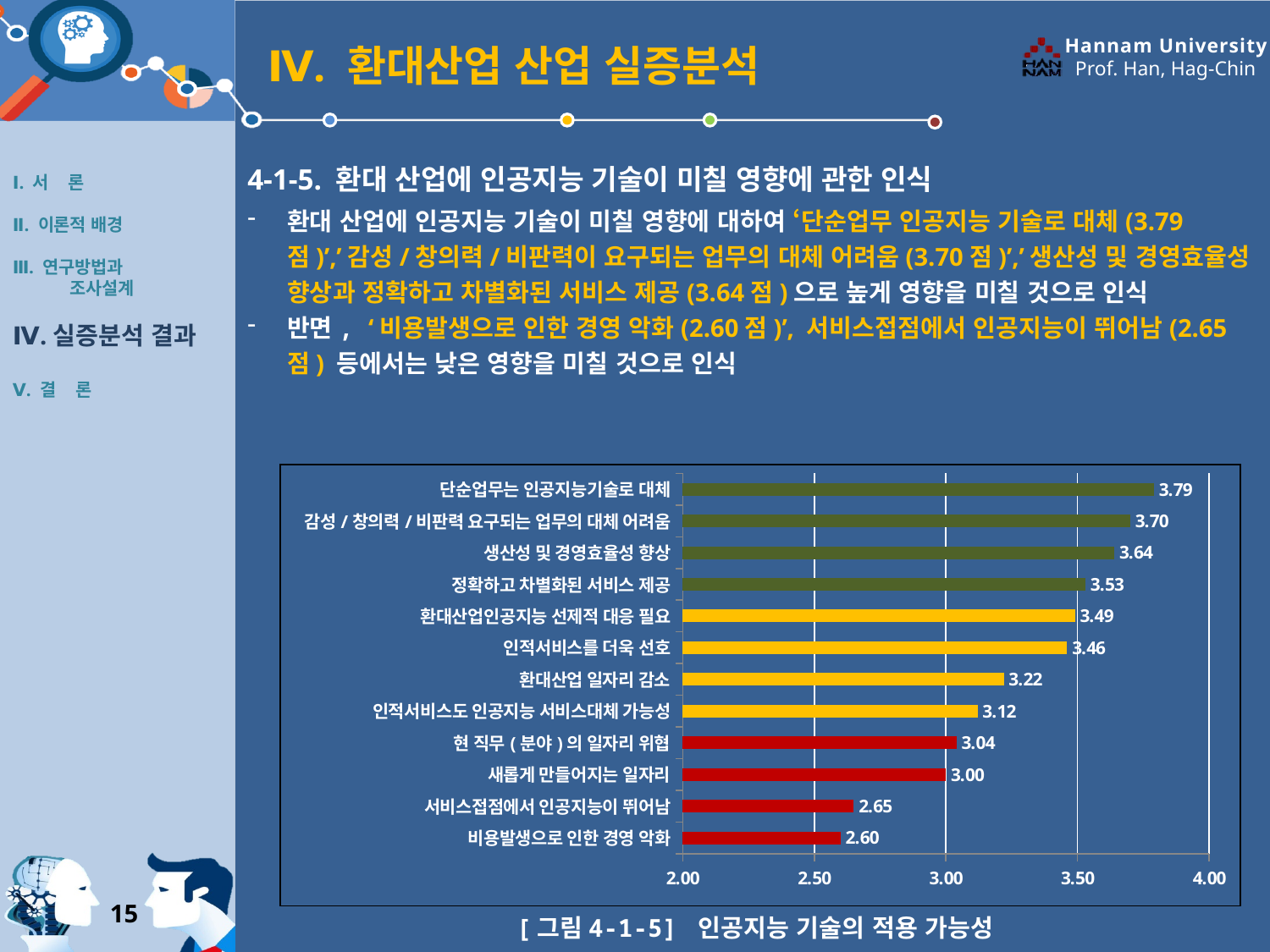
What is the difference between the values for '단순업무는 인공지능기술로 대체' and '비용발생으로 인한 경영 악화'? 1.19 Which category has the highest value? 단순업무는 인공지능기술로 대체 How many categories are shown in the bar chart? 12 What is the value for '단순업무는 인공지능기술로 대체'? 3.79 Which category has the lowest value? 비용발생으로 인한 경영 악화 Is the value for '서비스접점에서 인공지능이 뛰어남' greater or less than 3.00? less What is the difference between the values for '생산성 및 경영효율성 향상' and '정확하고 차별화된 서비스 제공'? 0.11 What kind of chart is shown on the slide? bar chart What is the caption of the chart shown below the plot? [그림 4-1-5] 인공지능 기술의 적용 가능성 What is the value for '새롭게 만들어지는 일자리'? 3.00 Which is larger, the value for '인적서비스를 더욱 선호' or the value for '인적서비스도 인공지능 서비스대체 가능성'? 인적서비스를 더욱 선호 What is the value for '환대산업 일자리 감소'? 3.22